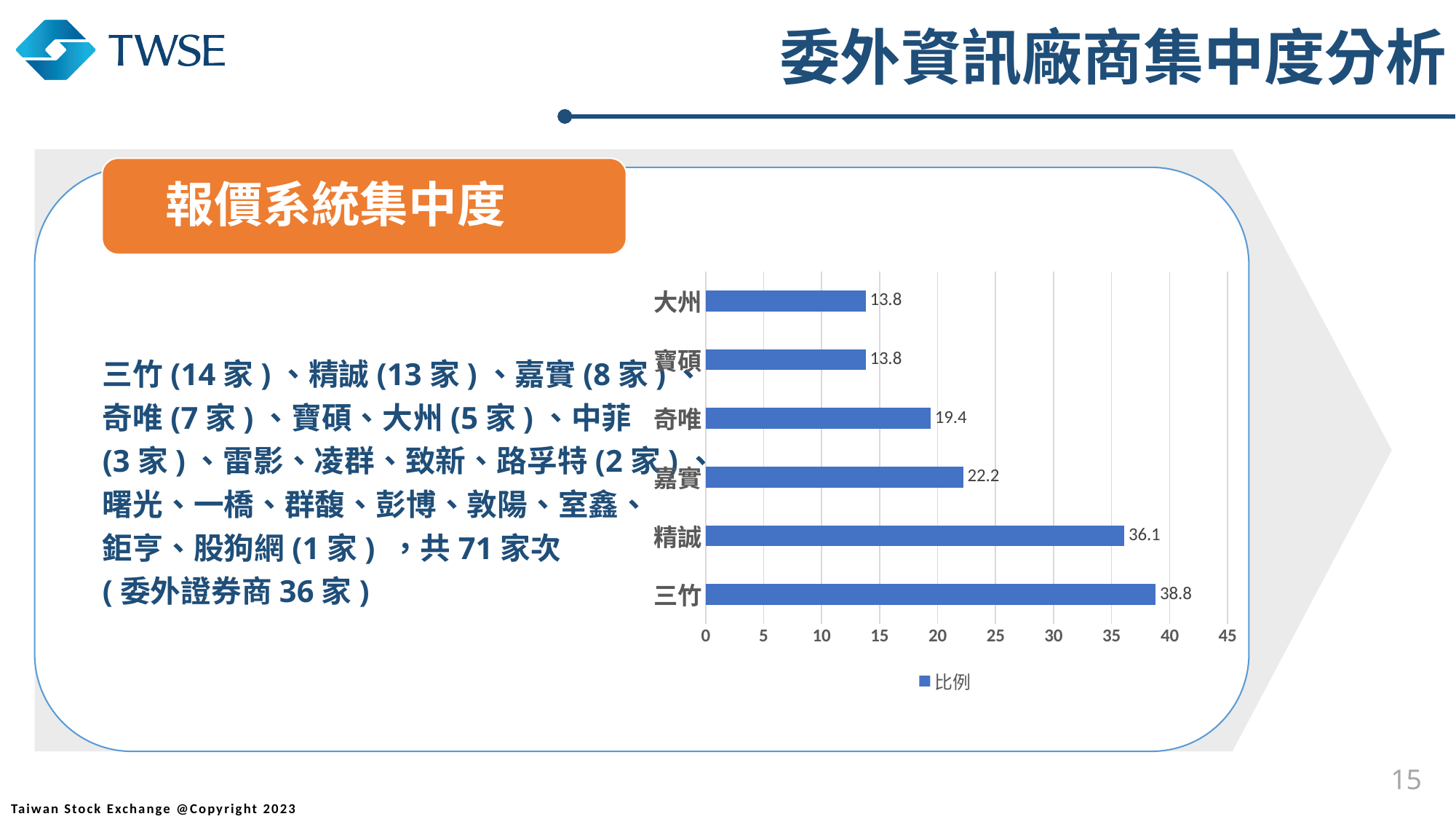
What is the value for 三竹? 38.8 What is the difference between the values for 三竹 and 精誠? 2.7 What is the difference between the values for 嘉實 and 奇唯? 2.8 What kind of chart is shown on the slide? bar chart What is the value for 奇唯? 19.4 Is the value for 奇唯 greater or less than 20? less Which is larger, the value for 精誠 or the value for 嘉實? 精誠 Which category has the highest value? 三竹 How many categories are shown in the chart? 6 What is the value for 嘉實? 22.2 What is the value for 精誠? 36.1 What series name does the legend show? 比例